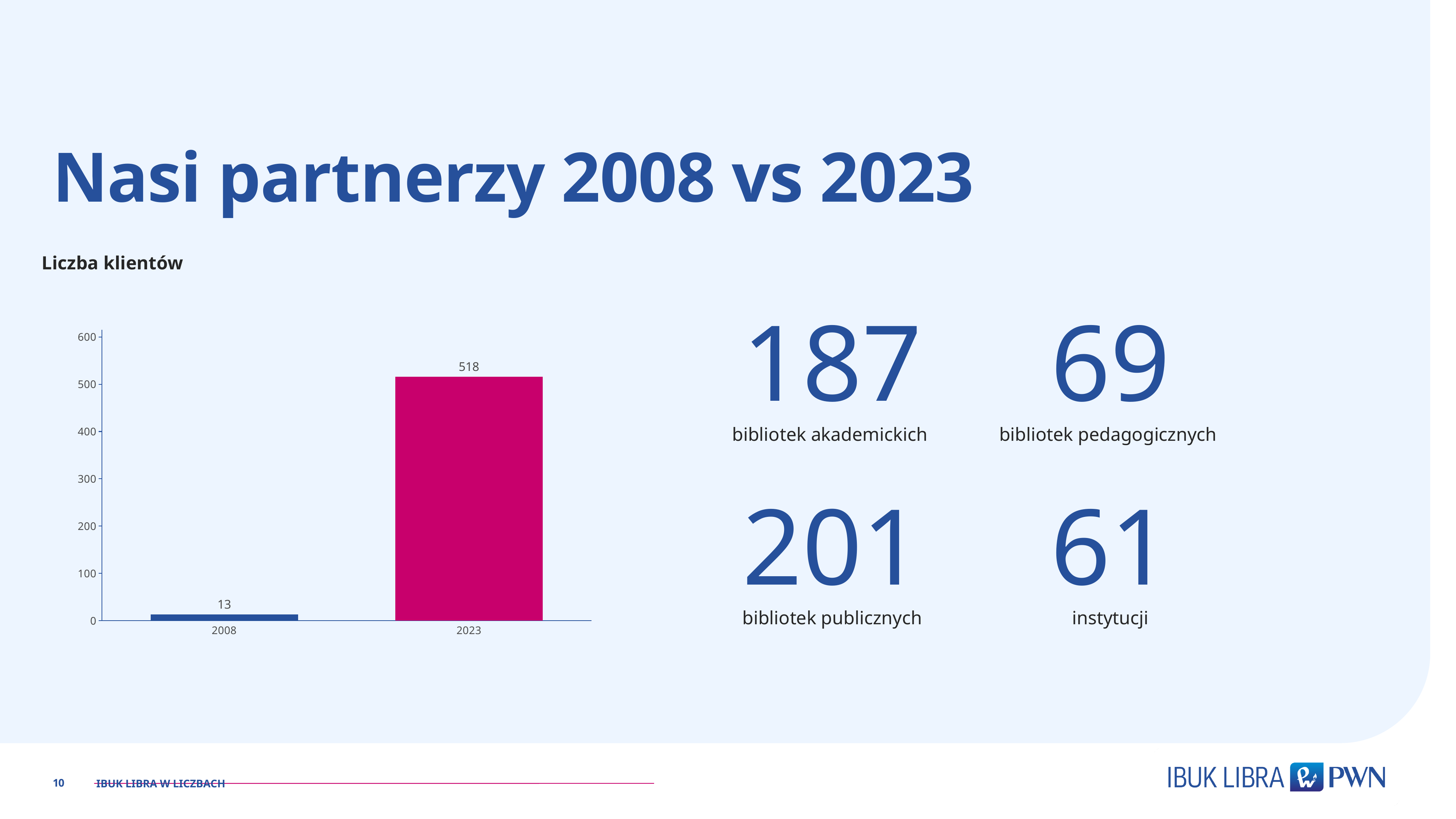
Which year has the higher value in the chart? 2023 What is the difference between the values for 2023 and 2008? 505 What is the highest tick value shown on the y axis of the chart? 600 Is the value for 2008 greater or less than 100? less Do the values rise or fall from 2008 to 2023? rise Is the value for 2023 greater or less than 500? greater How many categories are shown on the x axis of the chart? 2 Which year has the lower value in the chart? 2008 What kind of chart is shown on the slide? bar chart What is the value for 2023 in the chart? 518 What is the value for 2008 in the chart? 13 What is the title of the chart? Liczba klientów